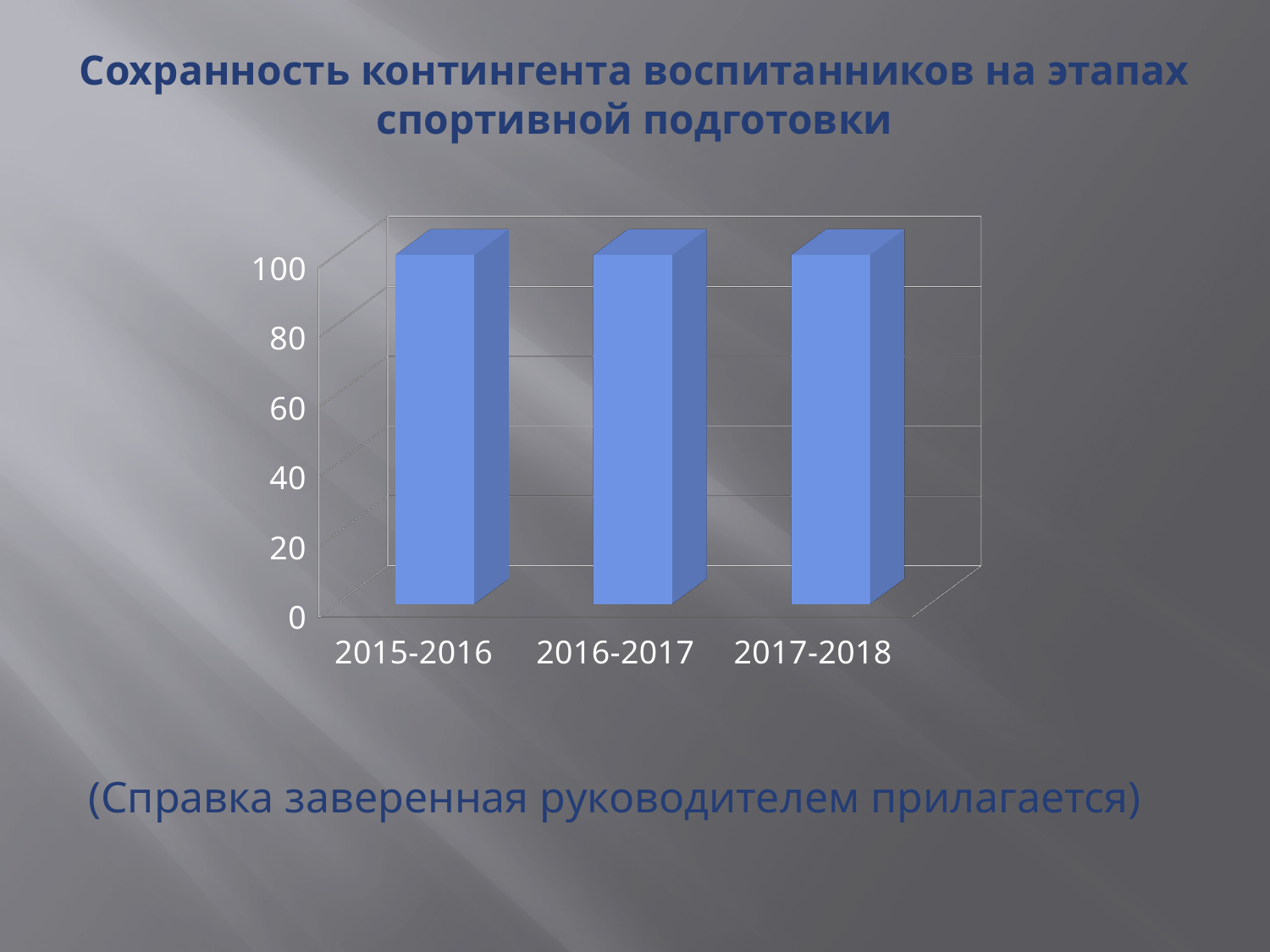
Which period is the first category on the x axis? 2015-2016 What is the title of the slide containing the chart? Сохранность контингента воспитанников на этапах спортивной подготовки Is the value for 2016-2017 greater or less than 60? greater Is the value for 2015-2016 greater or less than 80? greater Is the value for 2017-2018 greater or less than 80? greater What is the highest tick value shown on the vertical axis? 100 How many categories (periods) are shown on the x axis of the chart? 3 What kind of chart is shown on the slide? bar chart What value does the bar for 2017-2018 reach on the axis? 100 What value does the bar for 2015-2016 reach on the axis? 100 Which period is the last category on the x axis? 2017-2018 Do the values rise, fall, or stay the same from 2015-2016 to 2017-2018? stay the same